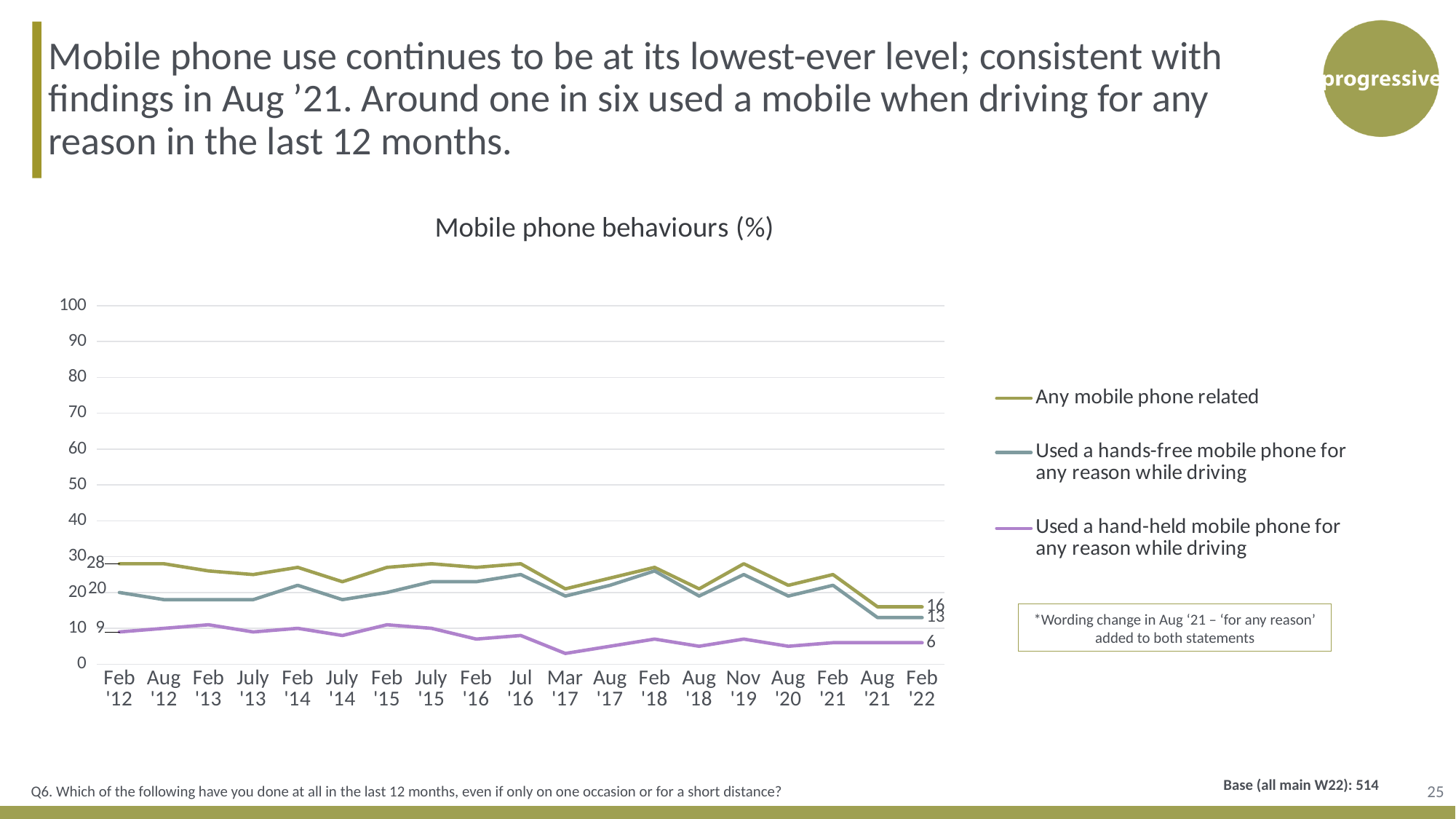
Which is larger in Feb '12: the hands-free value or the hand-held value? Hands-free How many series does the legend list? 3 Which series has the lowest value in Feb '22? Used a hand-held mobile phone for any reason while driving Is the value for 'Any mobile phone related' in Nov '19 greater or less than 20? greater What is the value for 'Any mobile phone related' in Feb '12? 28 What is the value for 'Used a hand-held mobile phone for any reason while driving' in Feb '12? 9 What is the value for 'Used a hands-free mobile phone for any reason while driving' in Feb '22? 13 What kind of chart is shown on the slide? Line chart What is the value for 'Any mobile phone related' in Feb '22? 16 How many time points are shown on the x axis? 19 What is the difference between the hands-free value in Feb '12 and in Feb '22? 7 By how much did the 'Any mobile phone related' value fall between Feb '12 and Feb '22? 12